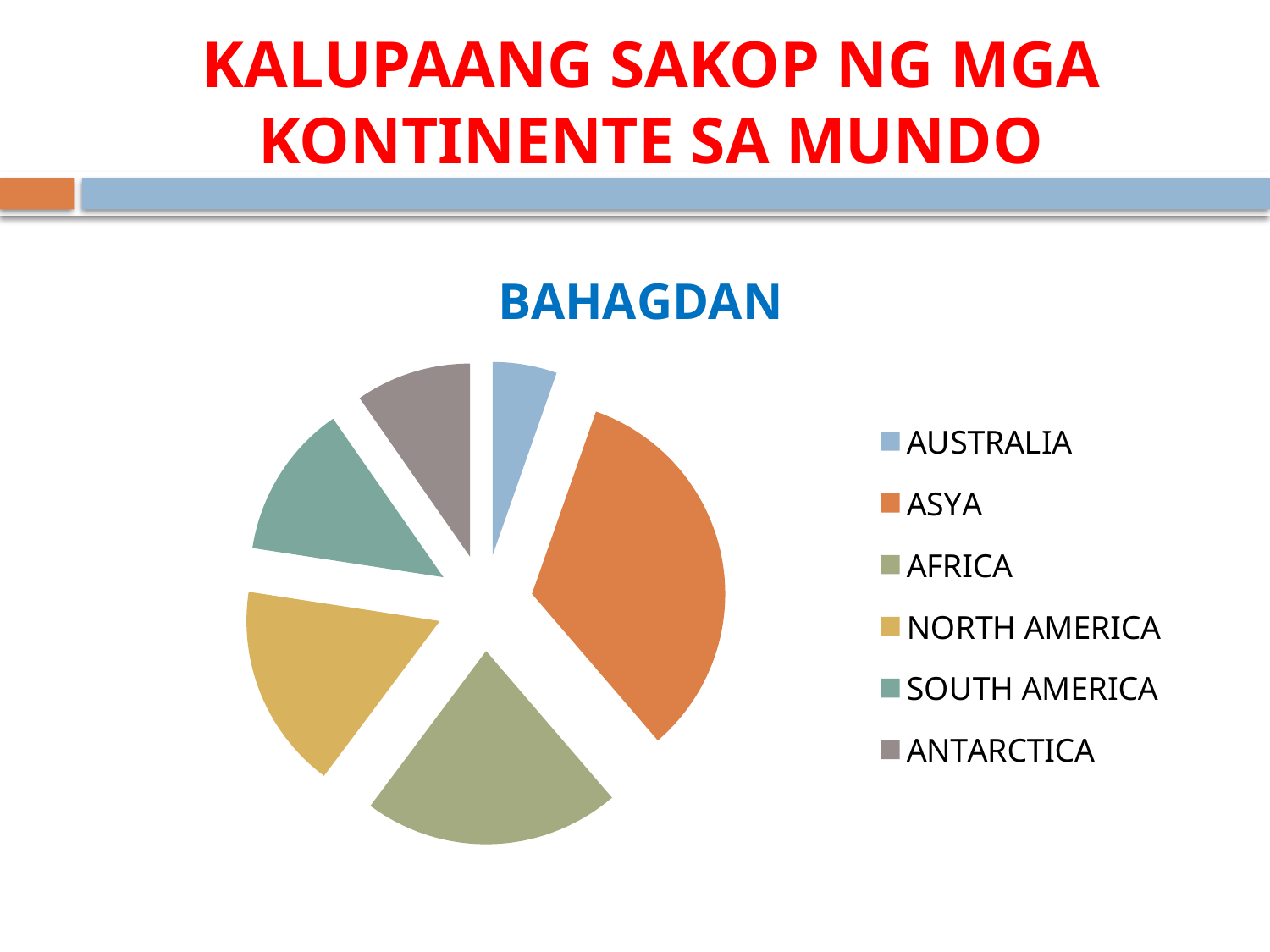
Which continent is represented by the orange slice? ASYA Which continent has the smallest slice of the pie? AUSTRALIA How many slices does the pie chart have? 6 How many entries does the chart's legend list? 6 Which slice is larger, AFRICA or AUSTRALIA? AFRICA What kind of chart is shown on the slide? Pie chart What is the title of the chart? BAHAGDAN Which slice is larger, AUSTRALIA or ANTARCTICA? ANTARCTICA Which slice is larger, ASYA or NORTH AMERICA? ASYA Which continent has the largest slice of the pie? ASYA